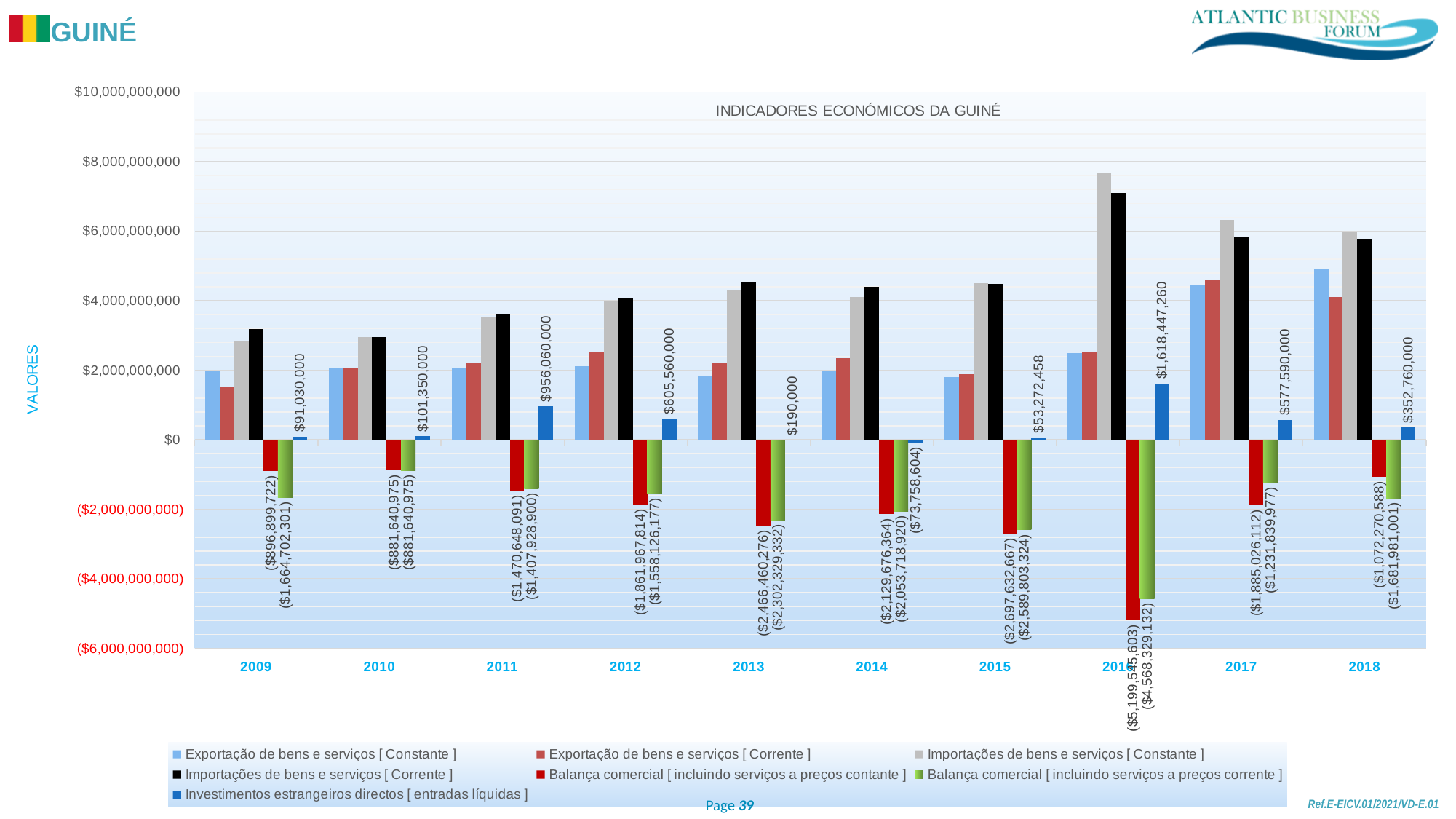
What is the title of the chart? INDICADORES ECONÓMICOS DA GUINÉ What is the value of Balança comercial [incluindo serviços a preços contante] in 2013? ($2,466,460,276) Which year has the larger value for Investimentos estrangeiros directos [entradas líquidas], 2011 or 2012? 2011 In which year is Investimentos estrangeiros directos [entradas líquidas] highest? 2016 What is the value of Investimentos estrangeiros directos [entradas líquidas] in 2016? $1,618,447,260 What is the difference between Investimentos estrangeiros directos [entradas líquidas] in 2010 and in 2009? $10,320,000 How many years are shown on the x axis? 10 In which year is Investimentos estrangeiros directos [entradas líquidas] lowest? 2014 How many series does the legend list? 7 What type of chart is shown on the slide? bar chart What is the value of Balança comercial [incluindo serviços a preços corrente] in 2018? ($1,681,981,001) Is the value of Importações de bens e serviços [Constante] in 2016 greater or less than $6,000,000,000? greater